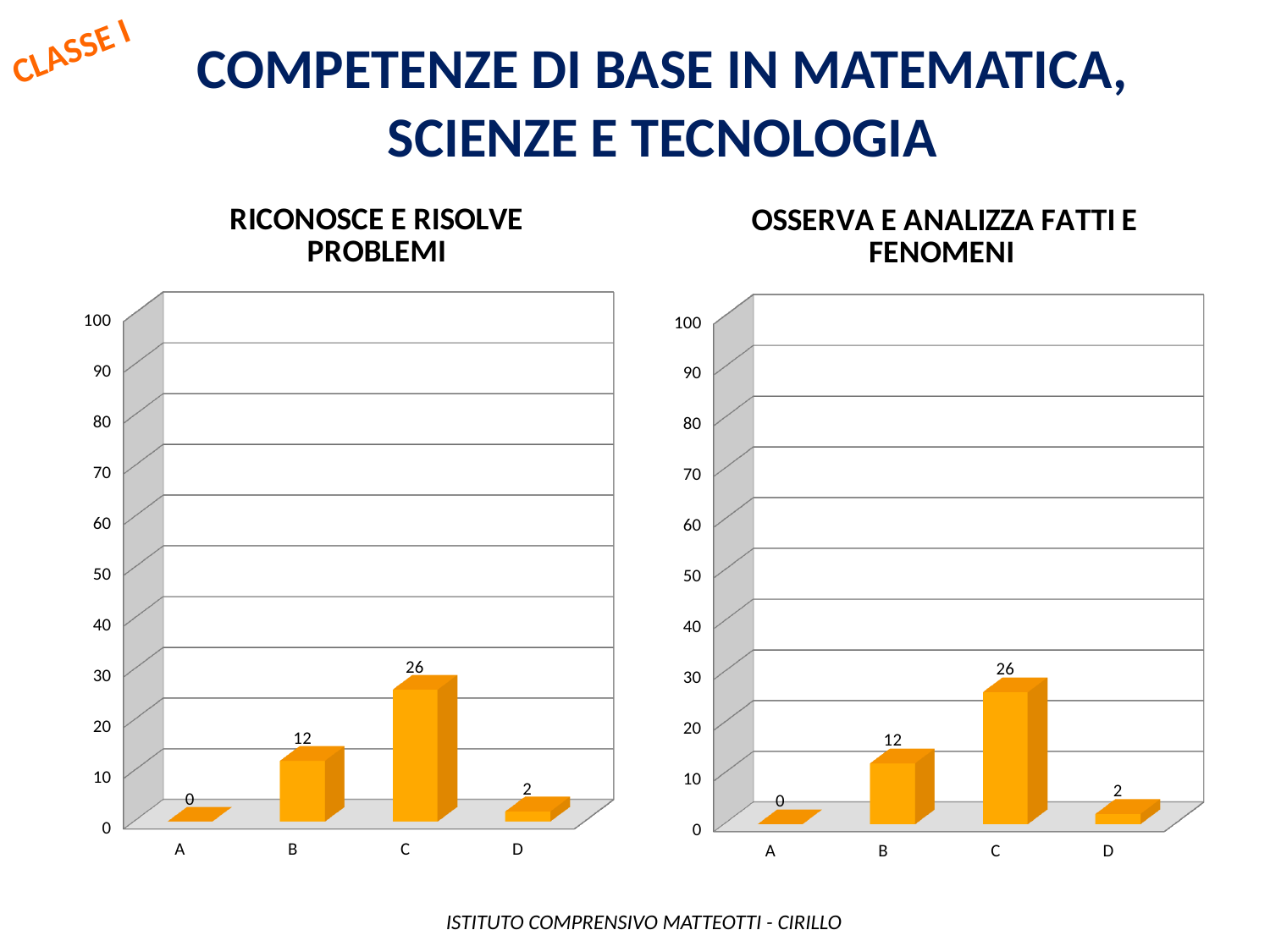
In the chart titled 'OSSERVA E ANALIZZA FATTI E FENOMENI', what is the difference between the values for B and D? 10 In the chart titled 'RICONOSCE E RISOLVE PROBLEMI', which is larger, the value for B or the value for D? B In the chart titled 'RICONOSCE E RISOLVE PROBLEMI', what is the value for category C? 26 In the chart titled 'RICONOSCE E RISOLVE PROBLEMI', what is the difference between the values for C and B? 14 What kind of chart is the chart titled 'OSSERVA E ANALIZZA FATTI E FENOMENI'? bar chart In the chart titled 'OSSERVA E ANALIZZA FATTI E FENOMENI', which category has the lowest value? A How many categories are shown in the chart titled 'RICONOSCE E RISOLVE PROBLEMI'? 4 In the chart titled 'RICONOSCE E RISOLVE PROBLEMI', what is the value for category B? 12 In the chart titled 'RICONOSCE E RISOLVE PROBLEMI', which category has the highest value? C In the chart titled 'OSSERVA E ANALIZZA FATTI E FENOMENI', what is the value for category D? 2 In the chart titled 'OSSERVA E ANALIZZA FATTI E FENOMENI', what is the value for category A? 0 In the chart titled 'OSSERVA E ANALIZZA FATTI E FENOMENI', is the value for C greater or less than 20? greater